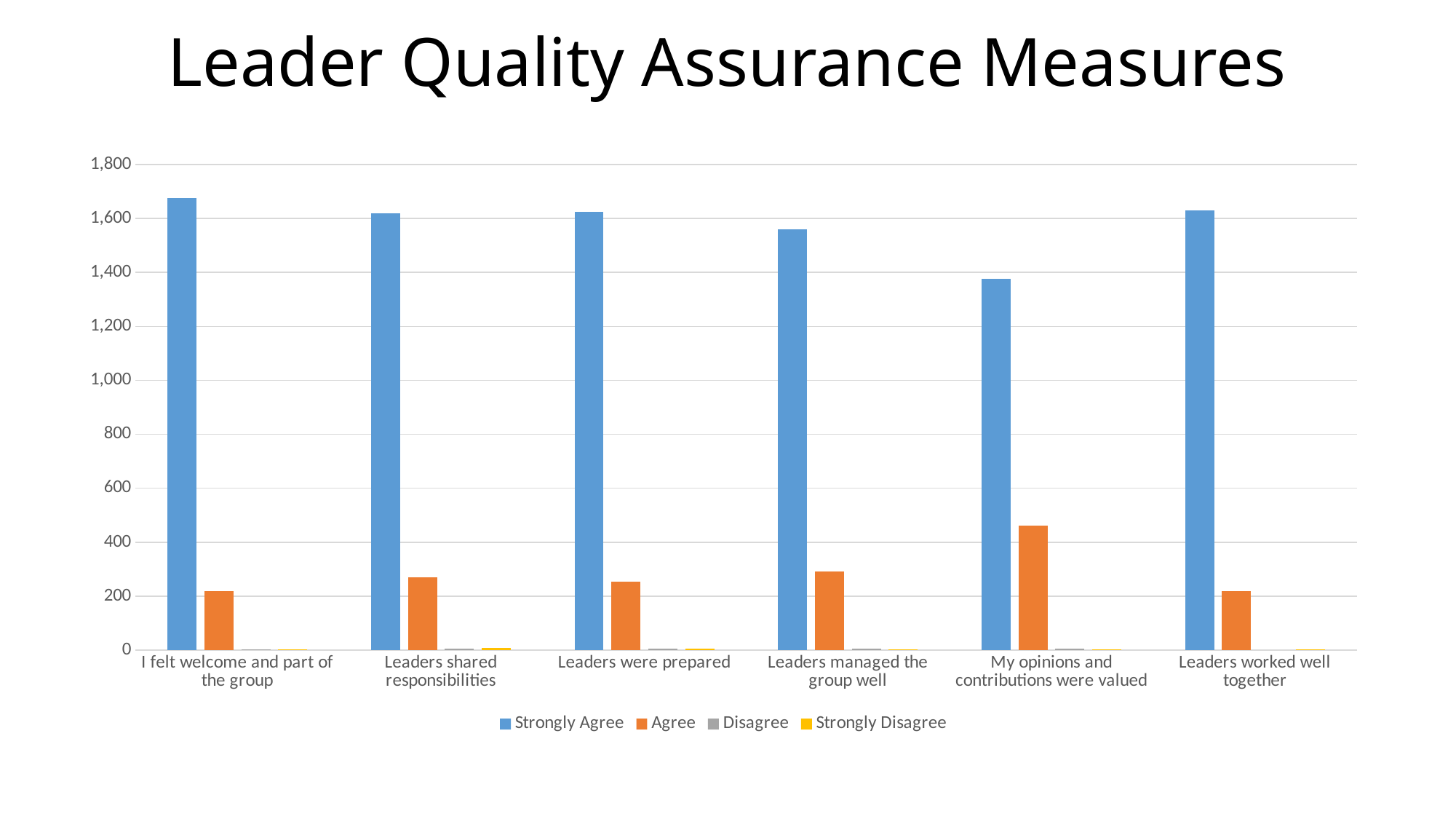
Which category has the highest Agree value? My opinions and contributions were valued What type of chart is shown on the slide? Bar chart Is the Strongly Agree value for 'My opinions and contributions were valued' greater or less than 1,400? less Is the Agree value for 'My opinions and contributions were valued' greater or less than 400? greater Which is larger: the Strongly Agree value for 'Leaders were prepared' or for 'My opinions and contributions were valued'? Leaders were prepared How many categories are shown on the x axis? 6 How many series does the legend list? 4 Which series is shown in orange in the legend? Agree Is the Strongly Agree value for 'Leaders managed the group well' greater or less than 1,400? greater What is the title of the chart? Leader Quality Assurance Measures Which category has the highest Strongly Agree value? I felt welcome and part of the group Which category has the lowest Strongly Agree value? My opinions and contributions were valued